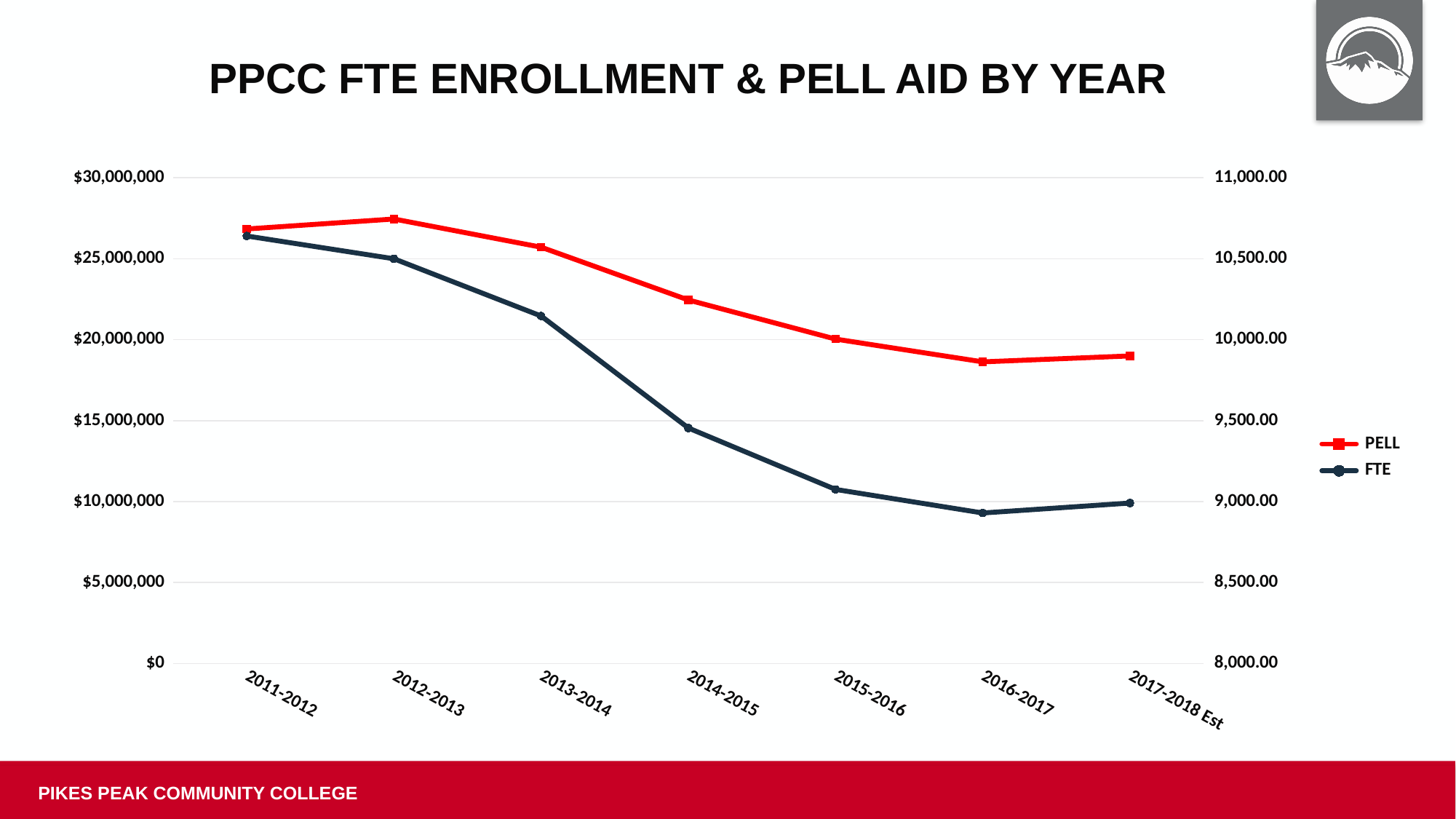
How many academic years are plotted along the x axis? 7 In which year is the PELL value lowest? 2016-2017 Is the PELL value for 2014-2015 greater or less than $20,000,000? greater Which year has the larger PELL value, 2013-2014 or 2015-2016? 2013-2014 Is the FTE value for 2014-2015 greater or less than 10,000.00? less How many series does the legend list? 2 Is the PELL value for 2016-2017 greater or less than $20,000,000? less In which year is the PELL value highest? 2012-2013 What type of chart is shown on the slide? Line chart Does the FTE line generally rise or fall from 2011-2012 to 2016-2017? Fall In which year is the FTE value highest? 2011-2012